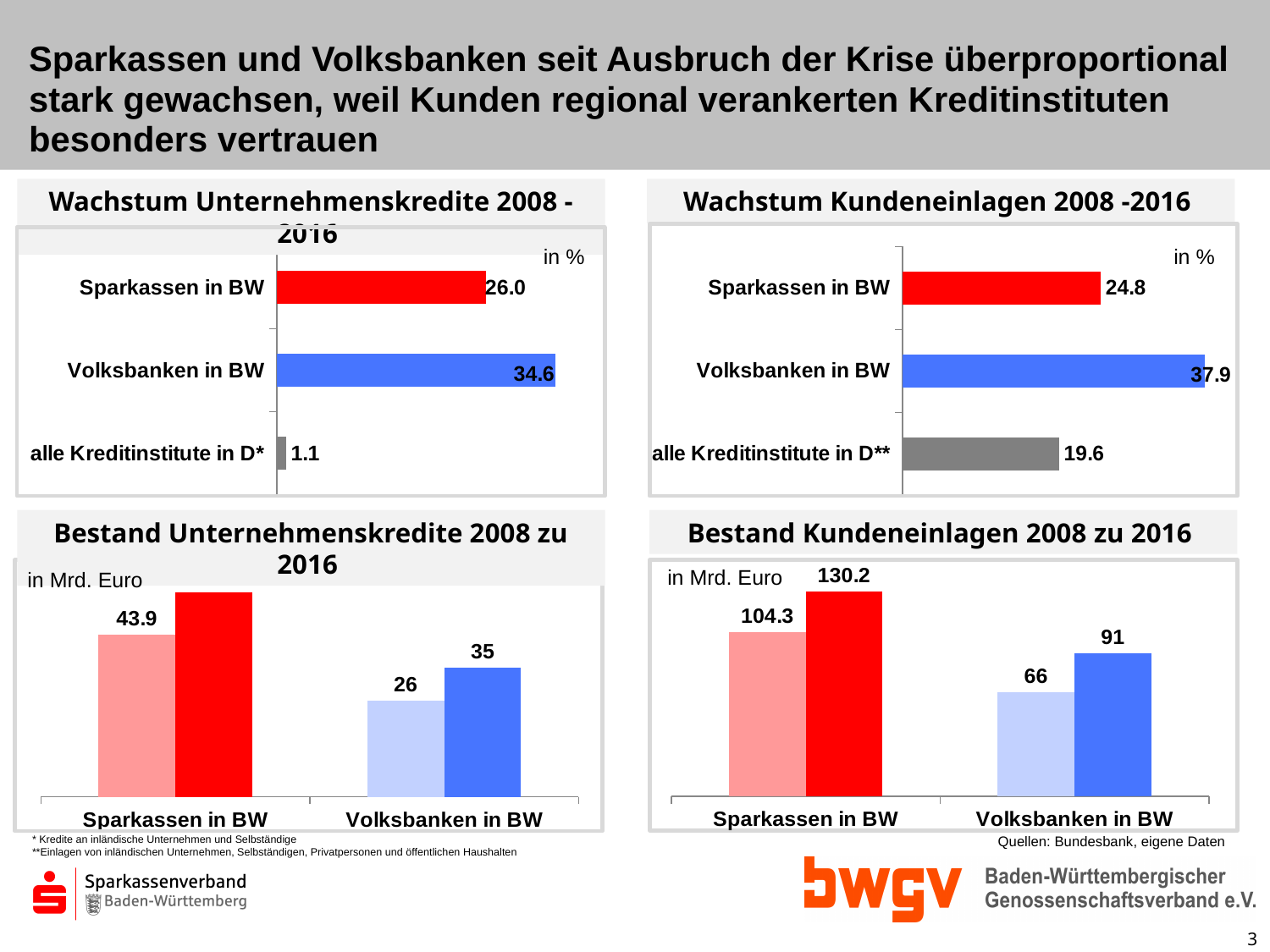
In the 'Bestand Kundeneinlagen 2008 zu 2016' chart, what is the value of the taller (dark red) bar for Sparkassen in BW? 130.2 In the 'Wachstum Unternehmenskredite 2008 - 2016' chart, what is the value for Volksbanken in BW? 34.6 How many categories are shown in the 'Wachstum Kundeneinlagen 2008 -2016' chart? 3 In the 'Wachstum Kundeneinlagen 2008 -2016' chart, which category has the highest value? Volksbanken in BW What type of chart is the 'Wachstum Unternehmenskredite 2008 - 2016' chart? bar chart In the 'Bestand Kundeneinlagen 2008 zu 2016' chart, what is the difference between the two bars for Volksbanken in BW? 25 In the 'Wachstum Kundeneinlagen 2008 -2016' chart, what is the value for alle Kreditinstitute in D**? 19.6 In the 'Wachstum Unternehmenskredite 2008 - 2016' chart, which category has the lowest value? alle Kreditinstitute in D* In the 'Bestand Unternehmenskredite 2008 zu 2016' chart, what is the value of the light blue bar for Volksbanken in BW? 26 In the 'Wachstum Unternehmenskredite 2008 - 2016' chart, what is the difference between the values for Volksbanken in BW and Sparkassen in BW? 8.6 What unit is shown for the values in the 'Bestand Kundeneinlagen 2008 zu 2016' chart? in Mrd. Euro In the 'Wachstum Kundeneinlagen 2008 -2016' chart, which is larger: the value for Sparkassen in BW or for alle Kreditinstitute in D**? Sparkassen in BW